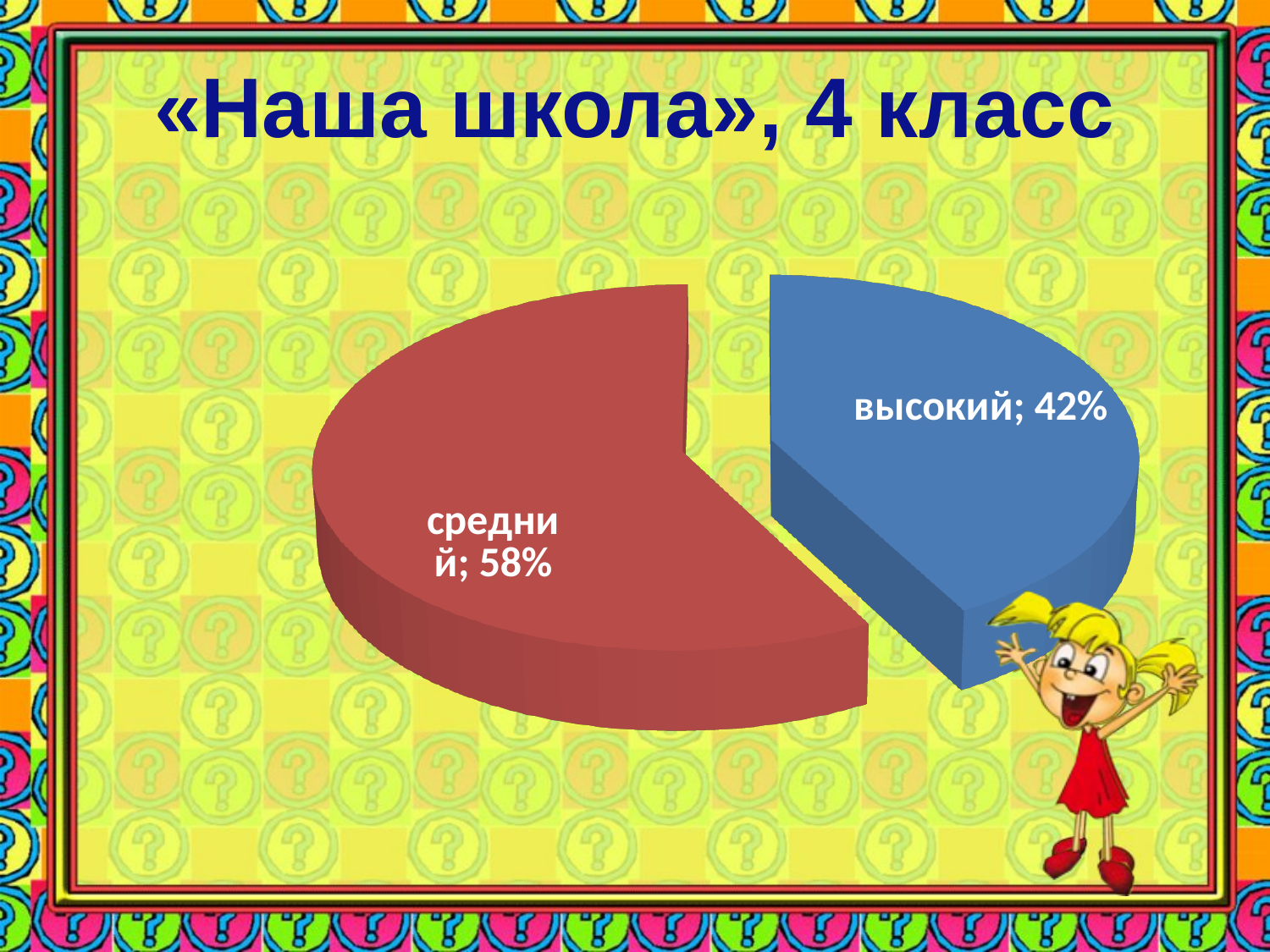
What is the value for the "высокий" slice? 42% Is the share for "высокий" greater or less than 50%? less How many slices does the pie chart have? 2 Which category has the largest share of the pie? средний What is the title of the slide containing the chart? «Наша школа», 4 класс What is the difference between the "средний" and "высокий" shares? 16% What type of chart is shown on the slide? pie chart Which category has the smallest share of the pie? высокий Which is larger, the "средний" slice or the "высокий" slice? средний What colour is the "высокий" slice? blue What is the value for the "средний" slice? 58%